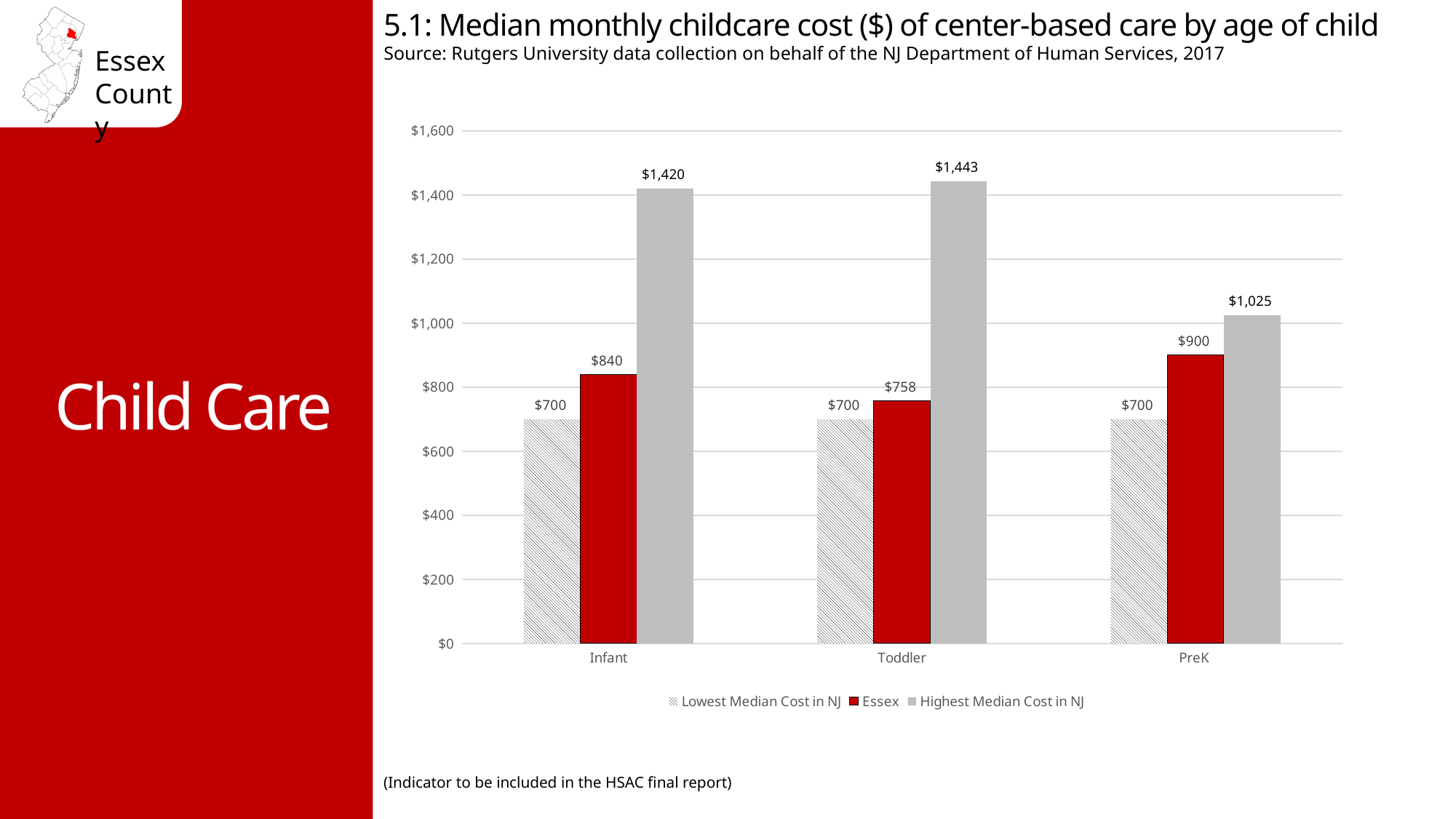
What is the difference between the Essex cost for PreK and the Essex cost for Toddler? $142 Is the Essex cost for PreK greater or less than $1,000? less How many series does the legend list? 3 What is the Highest Median Cost in NJ for Toddler care? $1,443 How many age groups are shown on the x axis? 3 What is the median monthly childcare cost for Essex for Infant care? $840 What is the Lowest Median Cost in NJ for PreK care? $700 Which is larger: the Essex cost for Infant or the Essex cost for Toddler? Infant For which age group is the Highest Median Cost in NJ lowest? PreK What is the difference between the Highest Median Cost in NJ and the Essex cost for Infant care? $580 For which age group is the Essex median monthly cost highest? PreK What kind of chart is shown on the slide? bar chart